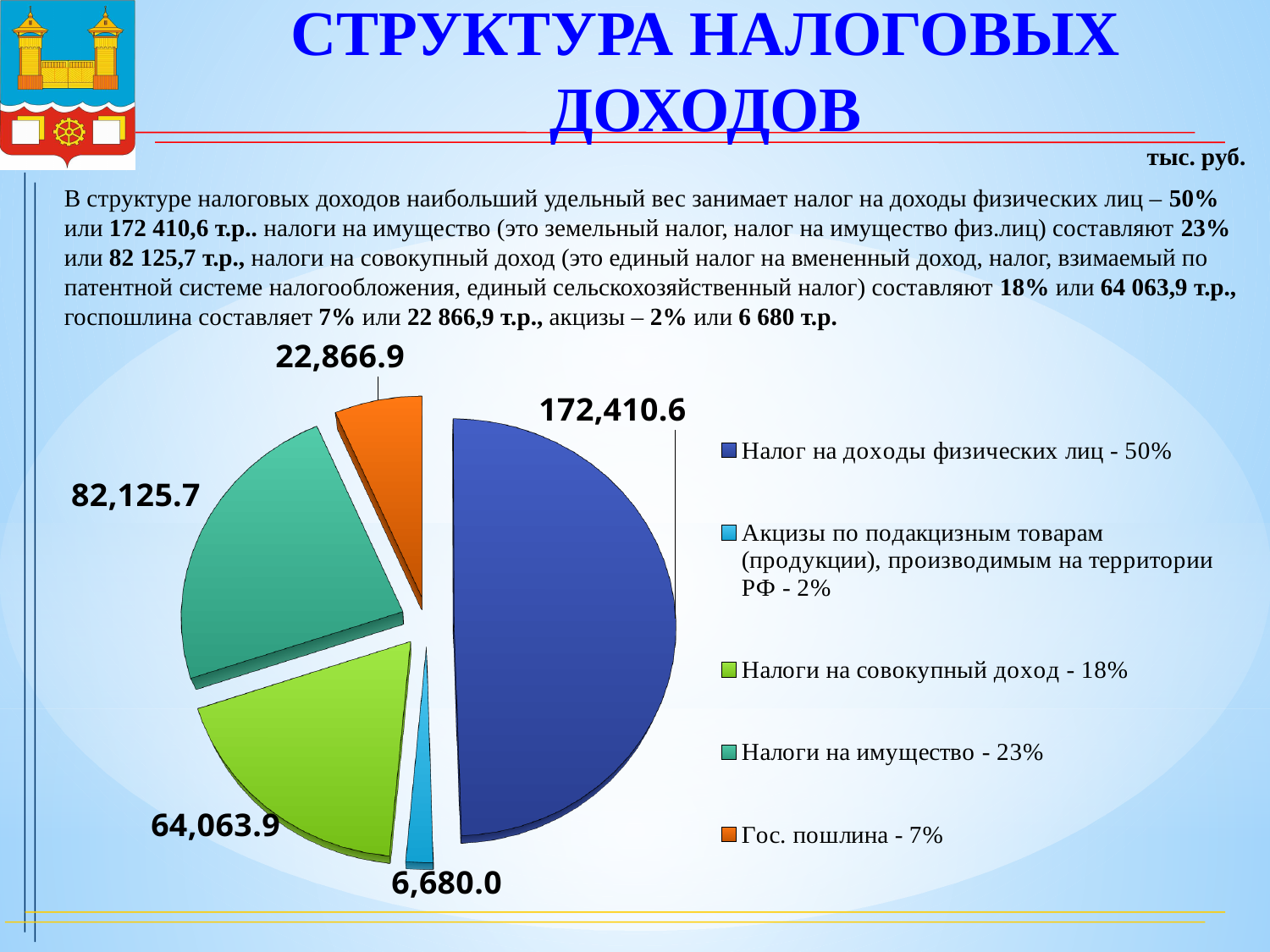
What is the value for Гос. пошлина? 22,866.9 What is the value for Налог на доходы физических лиц? 172,410.6 What kind of chart is shown on the slide? pie chart What is the value for Акцизы по подакцизным товарам? 6,680.0 What is the difference between the values for Налог на доходы физических лиц and Налоги на имущество? 90,284.9 Which category has the smallest slice of the pie? Акцизы по подакцизным товарам Which is larger, the value for Налоги на совокупный доход or the value for Гос. пошлина? Налоги на совокупный доход What share of the pie does Налоги на имущество represent? 23% What is the value for Налоги на совокупный доход? 64,063.9 What is the value for Налоги на имущество? 82,125.7 How many categories does the legend list? 5 Which category has the largest slice of the pie? Налог на доходы физических лиц